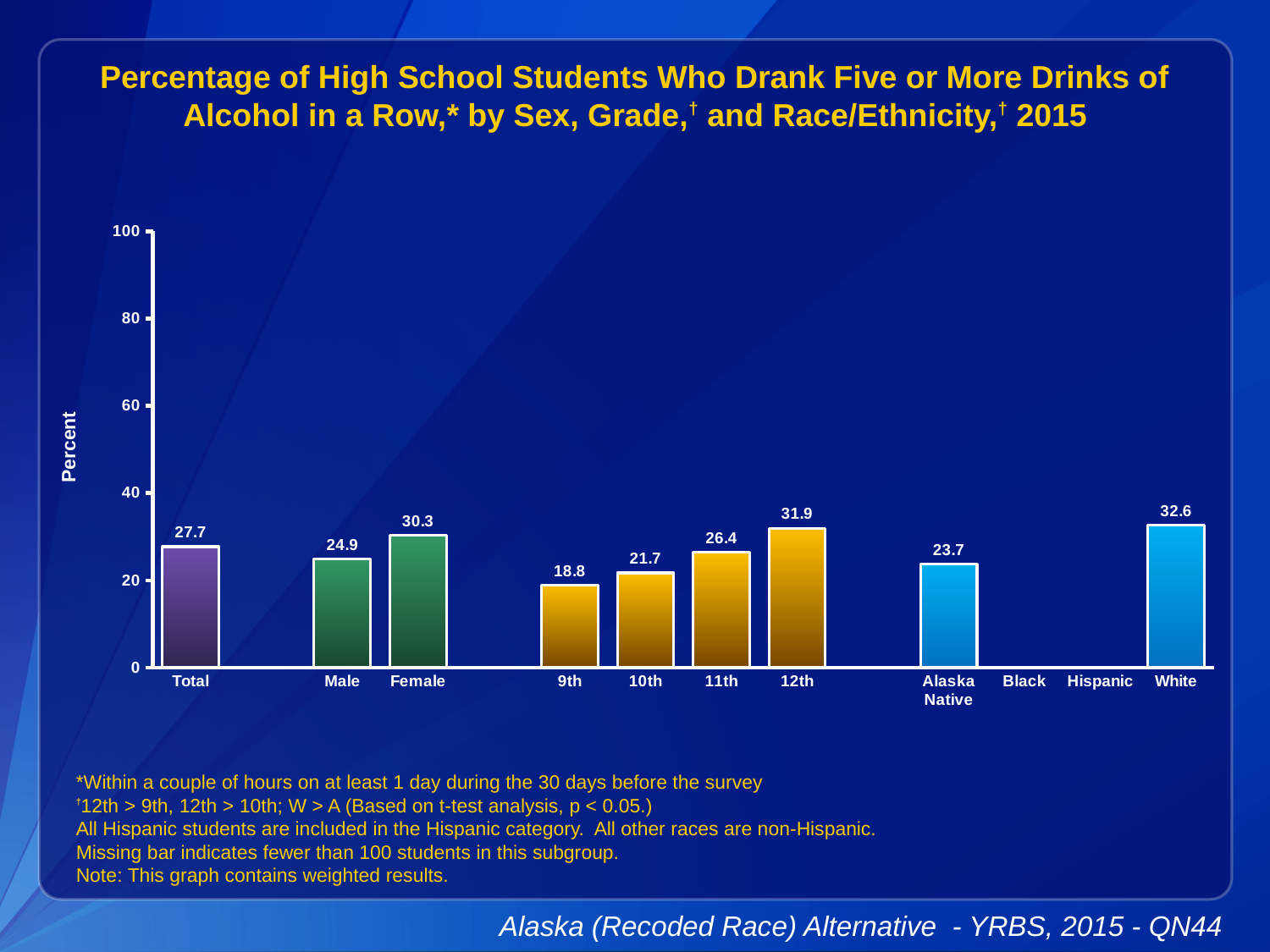
Do the values rise or fall from 9th grade to 12th grade? rise What is the difference between the values for 12th and 9th grade? 13.1 What kind of chart is shown on the slide? bar chart What is the value for 9th grade? 18.8 What is the value for Total? 27.7 Which category has the lowest value among the bars shown? 9th What is the value for Female? 30.3 What is the value for Alaska Native? 23.7 Which category has the highest value? White Is the value for White greater or less than 40? less Which is larger, the value for 11th grade or the value for 10th grade? 11th What is the difference between the values for Female and Male? 5.4